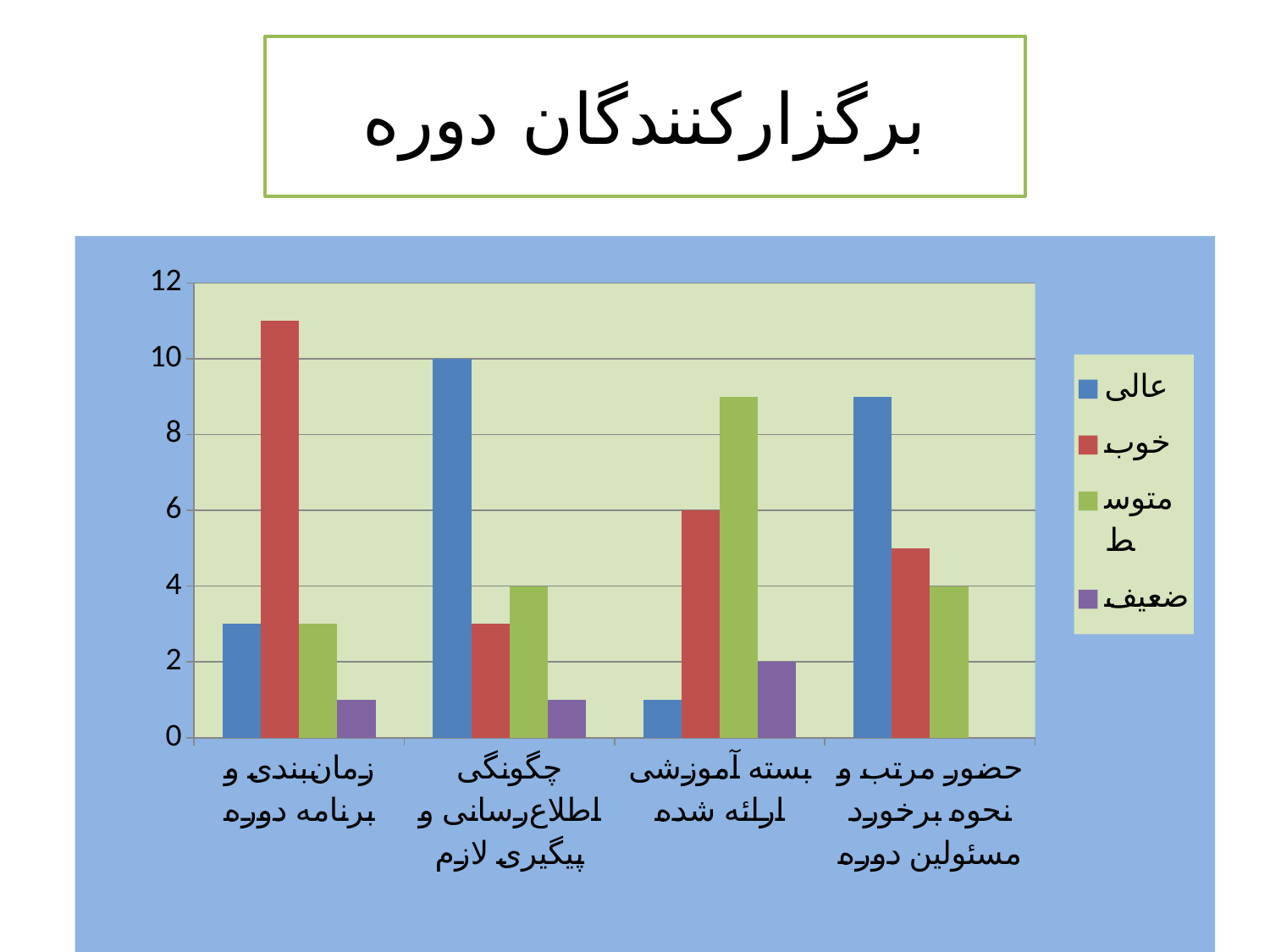
Is the value of خوب for زمان‌بندی و برنامه دوره greater or less than 10? greater How many series does the legend list? 4 Is the value of عالی for حضور مرتب و نحوه برخورد مسئولین دوره greater or less than 8? greater What is the value of عالی for the category چگونگی اطلاع‌رسانی و پیگیری لازم? 10 What is the value of خوب for the category بسته آموزشی ارائه شده? 6 What is the title of the slide? برگزارکنندگان دوره What kind of chart is shown on the slide? bar chart What is the value of متوسط for the category حضور مرتب و نحوه برخورد مسئولین دوره? 4 Which series has the highest value in the category بسته آموزشی ارائه شده? متوسط Which series has the highest value in the category زمان‌بندی و برنامه دوره? خوب How many categories are shown on the x axis? 4 In the category چگونگی اطلاع‌رسانی و پیگیری لازم, which is larger: عالی or خوب? عالی